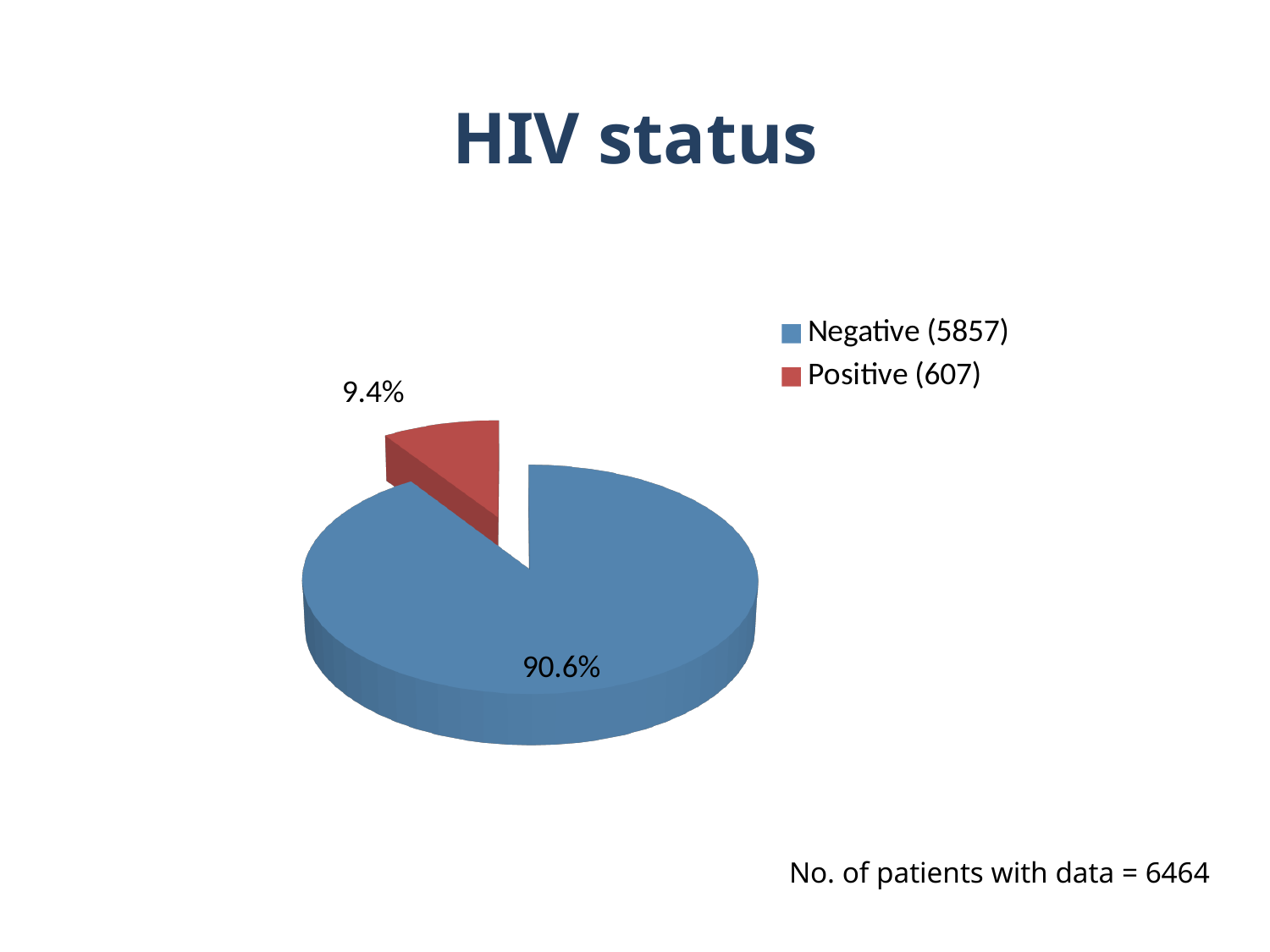
What is the difference in percentage points between the Negative and Positive shares? 81.2 How many patients are HIV Negative according to the legend? 5857 What colour is the Positive slice? red Which is larger, the Negative share or the Positive share? Negative How many patients are HIV Positive according to the legend? 607 What percentage of the pie is the Negative slice? 90.6% What type of chart is shown on the slide? pie chart What is the title of the chart? HIV status How many slices does the pie chart have? 2 What percentage of the pie is the Positive slice? 9.4% Which category has the largest share of the pie? Negative Which category has the smallest share of the pie? Positive